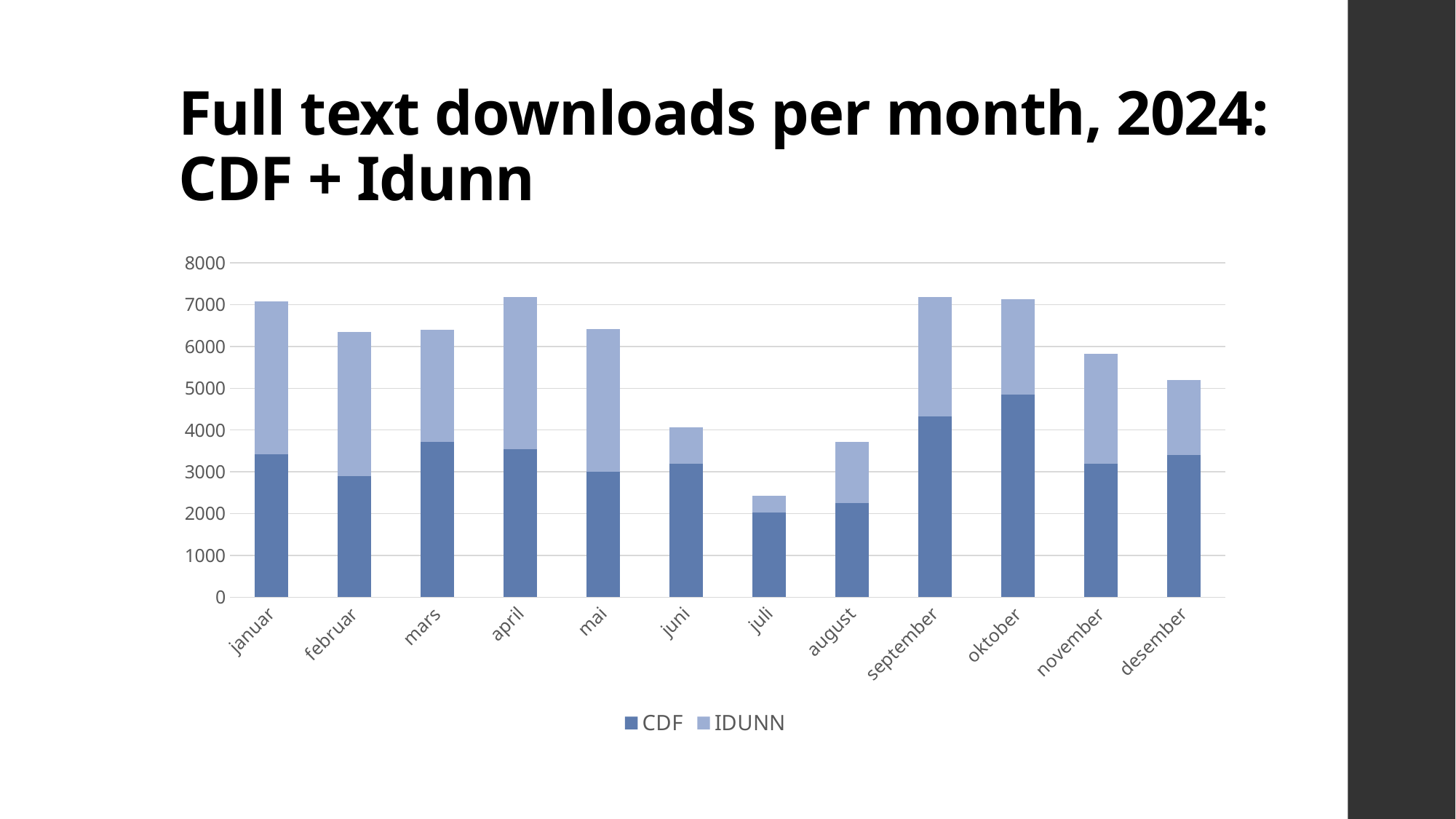
Which month has the highest CDF value? oktober Which month has the lowest CDF value? juli Which month has the lowest total downloads? juli Which has the larger total downloads, juli or august? august What kind of chart is shown on the slide? Stacked bar chart How many months are shown on the x axis of the chart? 12 Is the CDF value for oktober greater or less than 4000? greater Do the total downloads rise or fall from mai to juli? fall How many series does the legend list? 2 Which two series are listed in the legend? CDF and IDUNN Is the total for juli greater or less than 3000? less Is the total for august greater or less than 4000? less